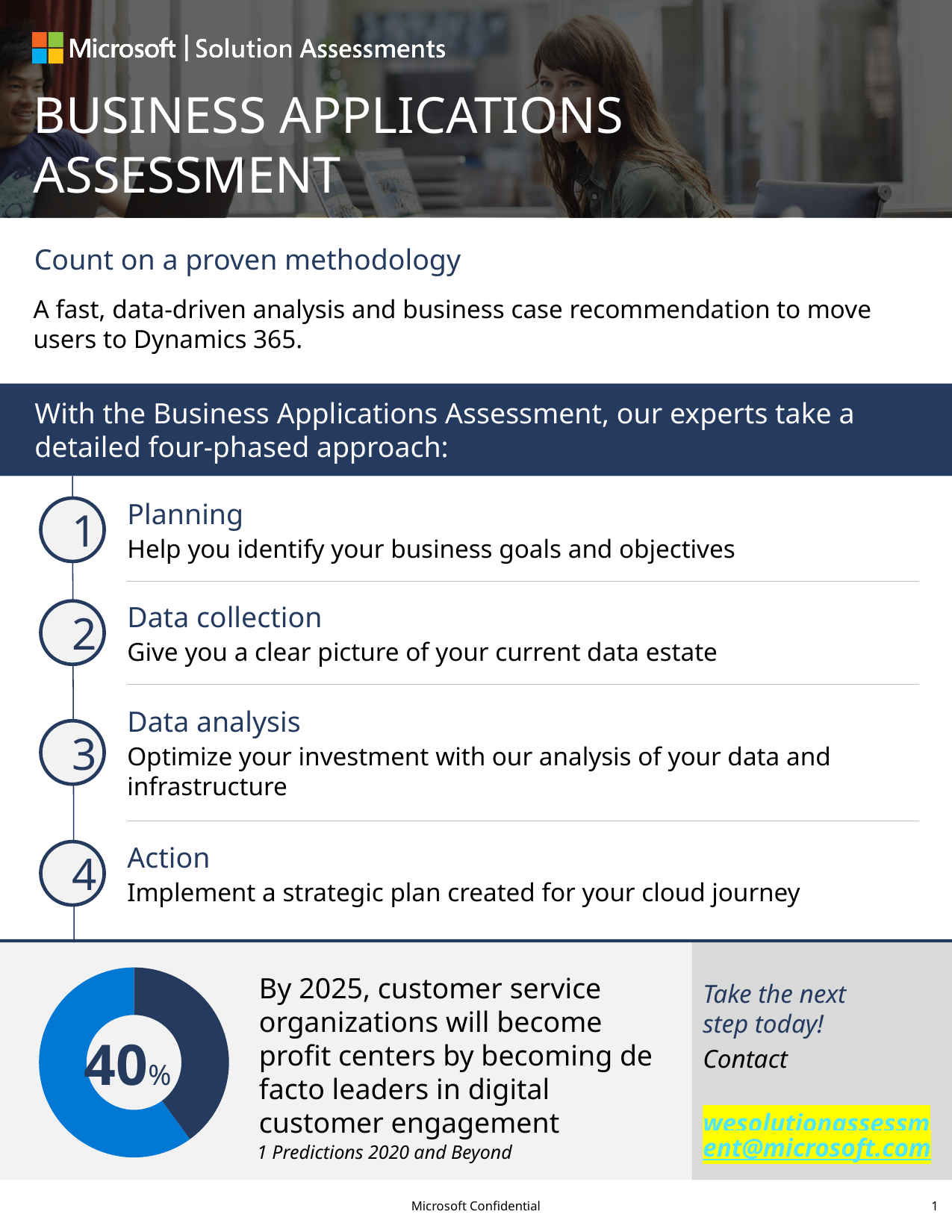
What share of the donut chart does the dark blue segment represent? 40% Which segment of the donut chart is larger, the dark blue one or the light blue one? The light blue one What source is cited beneath the text next to the donut chart? 1 Predictions 2020 and Beyond Is the dark blue segment of the donut chart greater or less than 50% of the ring? less How many segments does the donut chart have? 2 Is the light blue segment of the donut chart greater or less than 50% of the ring? greater What statistic does the donut chart illustrate, according to the text beside it? By 2025, customer service organizations will become profit centers by becoming de facto leaders in digital customer engagement What kind of chart is shown at the bottom left of the slide? Donut (pie) chart What percentage is printed in the centre of the donut chart? 40%